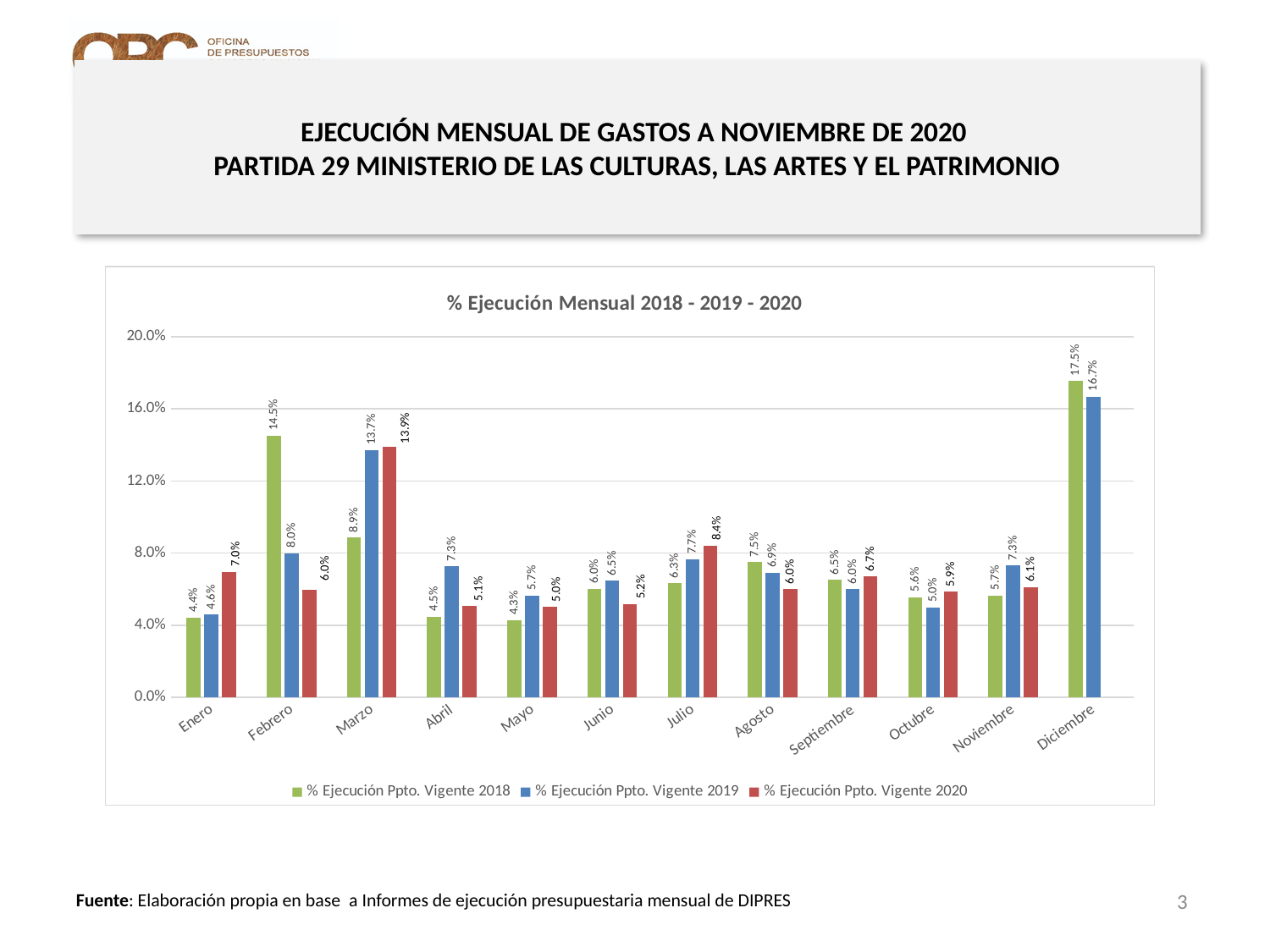
What is the value for % Ejecución Ppto. Vigente 2020 in Marzo? 13.9% How many months are shown on the x axis? 12 How many series does the legend list? 3 In Julio, which series has the larger value: % Ejecución Ppto. Vigente 2019 or % Ejecución Ppto. Vigente 2020? % Ejecución Ppto. Vigente 2020 Is the value for % Ejecución Ppto. Vigente 2019 in Marzo greater or less than 12.0%? greater What is the title of the chart? % Ejecución Mensual 2018 - 2019 - 2020 Which month has the highest value for % Ejecución Ppto. Vigente 2018? Diciembre What kind of chart is shown on the slide? Bar chart Which month has the lowest value for % Ejecución Ppto. Vigente 2020? Mayo What is the value for % Ejecución Ppto. Vigente 2019 in Noviembre? 7.3% What is the value for % Ejecución Ppto. Vigente 2018 in Febrero? 14.5% What is the difference between the 2018 and 2019 values in Diciembre? 0.8%